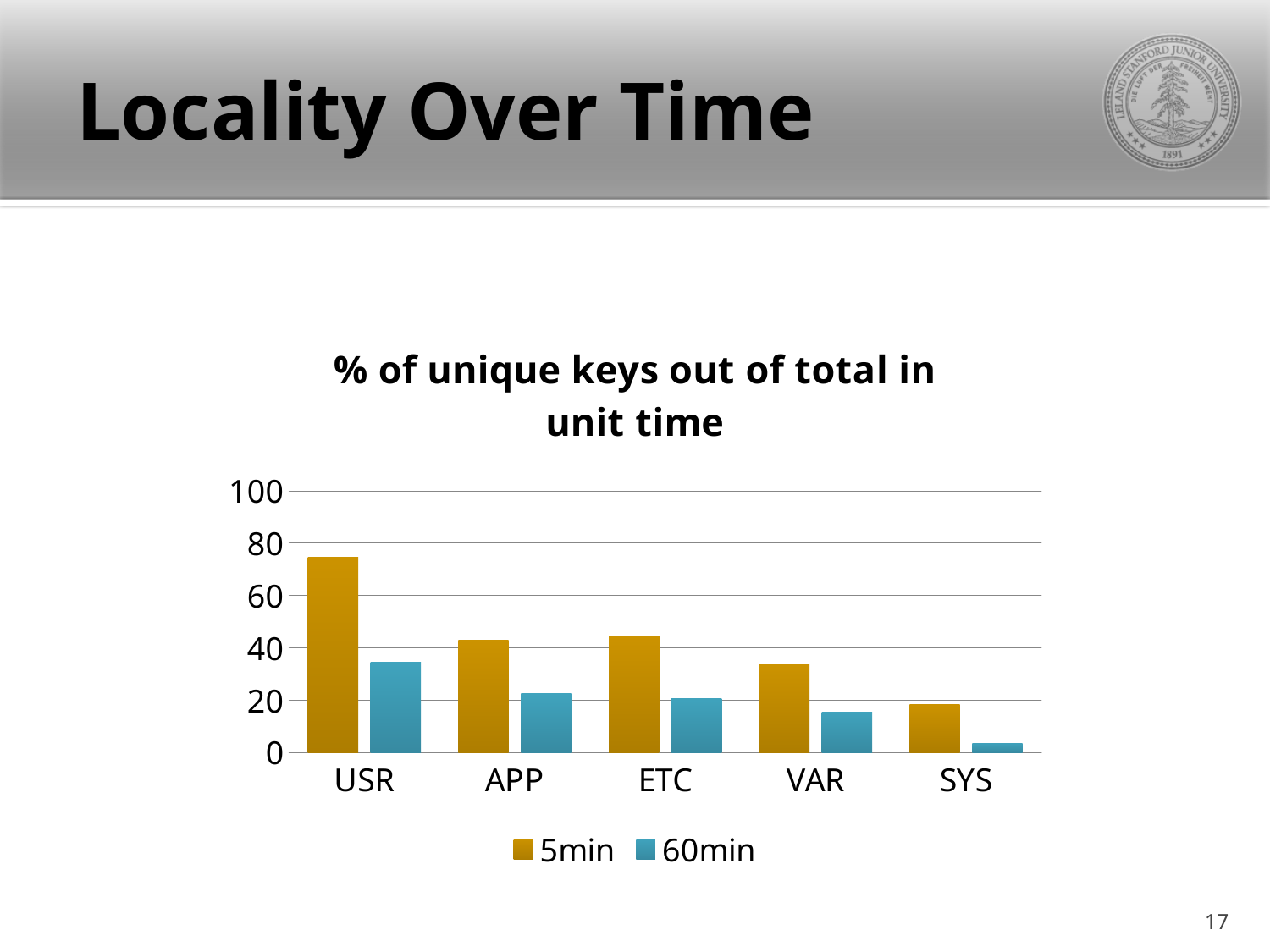
Is the 60min value for SYS greater or less than 20? less How many series does the legend list? 2 Which category has the highest 5min value? USR Is the 5min value for ETC greater or less than 40? greater What is the title of the chart? % of unique keys out of total in unit time Is the 5min value for USR greater or less than 60? greater Do the 60min values rise or fall from USR to SYS along the x axis? fall What kind of chart is shown on the slide? bar chart Which category has the lowest 60min value? SYS Which is larger, the 5min value for USR or the 5min value for APP? USR How many categories are shown on the x axis? 5